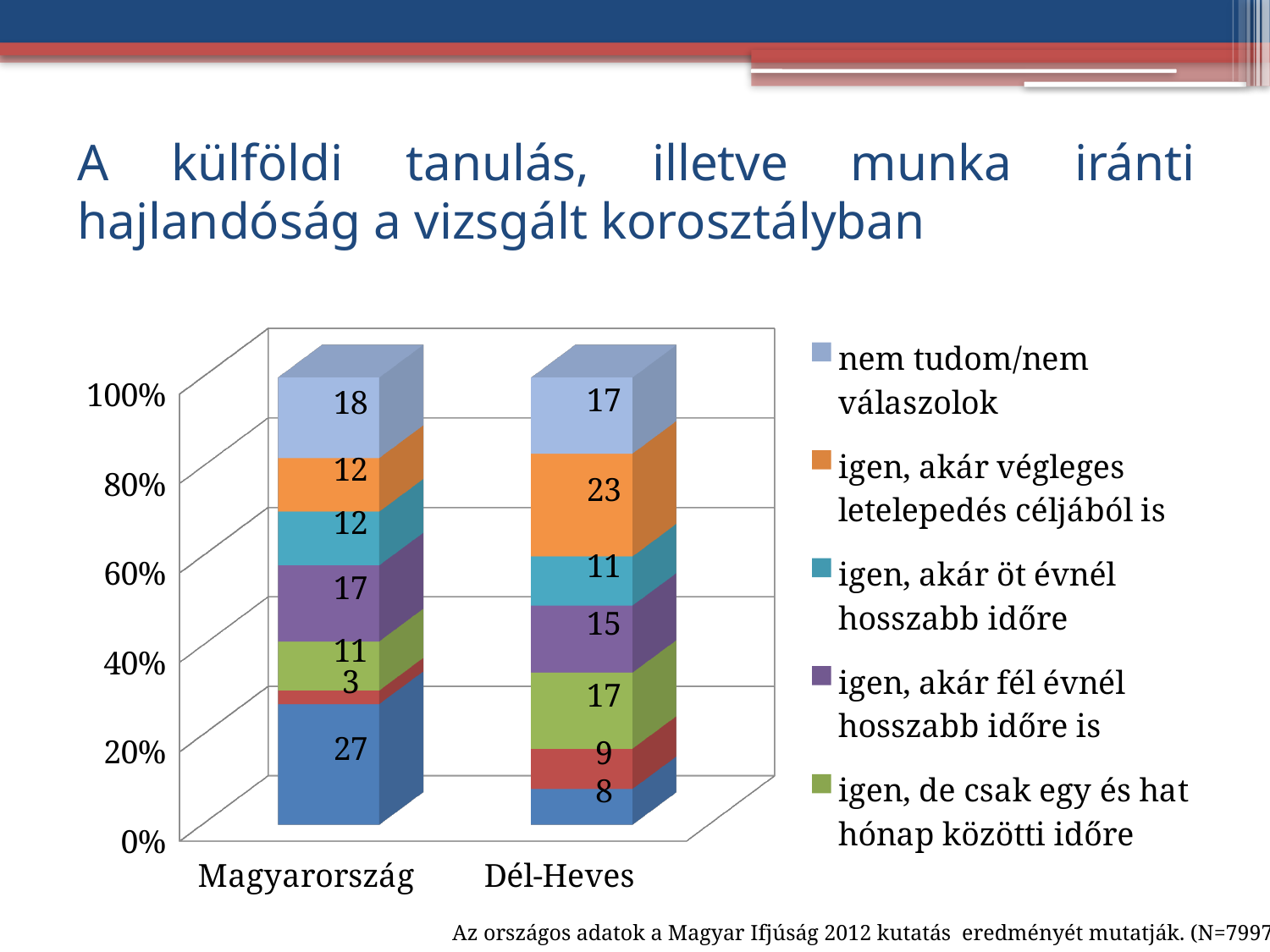
What are the two category labels on the x axis of the chart? Magyarország and Dél-Heves What is the total of all segments in the Magyarország bar? 100 What is the value of "igen, akár végleges letelepedés céljából is" for Dél-Heves? 23 Which category has the larger value for "igen, akár fél évnél hosszabb időre is", Magyarország or Dél-Heves? Magyarország What is the value of "igen, akár öt évnél hosszabb időre" for Dél-Heves? 11 What is the value of "igen, de csak egy és hat hónap közötti időre" for Dél-Heves? 17 What is the difference between Dél-Heves and Magyarország for "igen, akár végleges letelepedés céljából is"? 11 What kind of chart is shown on the slide? Stacked bar chart What is the value of "igen, akár fél évnél hosszabb időre is" for Magyarország? 17 What is the value of "nem tudom/nem válaszolok" for Magyarország? 18 Which category has the larger value for "igen, de csak egy és hat hónap közötti időre", Magyarország or Dél-Heves? Dél-Heves How many categories are shown on the x axis of the chart? 2